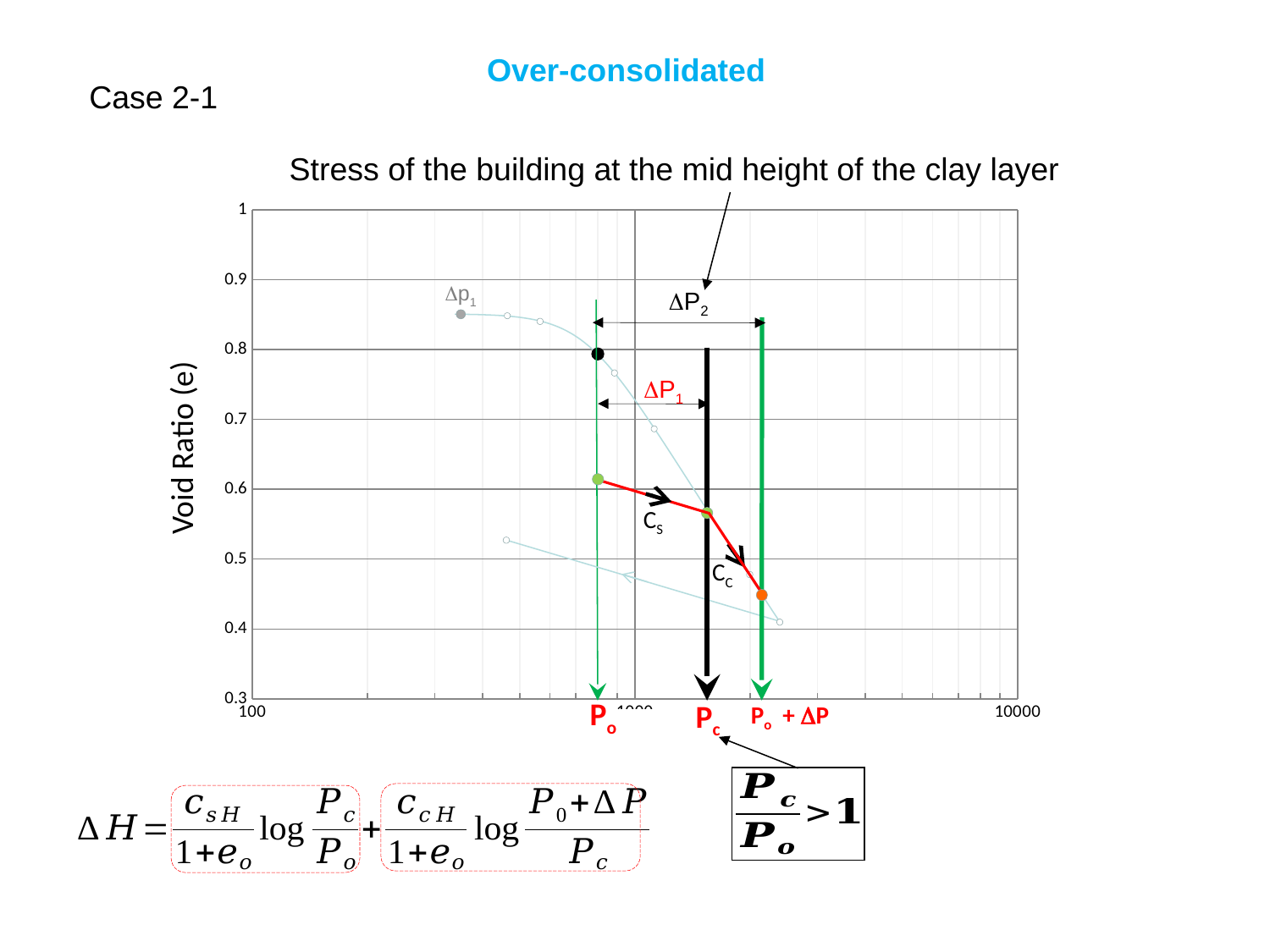
What is the label of the vertical axis of the chart? Void Ratio (e) Is the void ratio of the grey point labelled Δp1 greater or less than 0.8? greater What kind of chart is shown on the slide? line chart Along the red line, does the void ratio rise or fall as stress increases from Po to Po + ΔP? fall Is the void ratio of the orange point at Po + ΔP greater or less than 0.4? greater Is the void ratio of the orange point at Po + ΔP greater or less than 0.5? less Which point on the red line has the higher void ratio: the green point at Po or the orange point at Po + ΔP? the green point at Po Which label is written next to the steeper red segment between Pc and Po + ΔP? Cc What is the lowest value printed on the vertical axis of the chart? 0.3 What is the highest value printed on the horizontal axis of the chart? 10000 What is the lowest value printed on the horizontal axis of the chart? 100